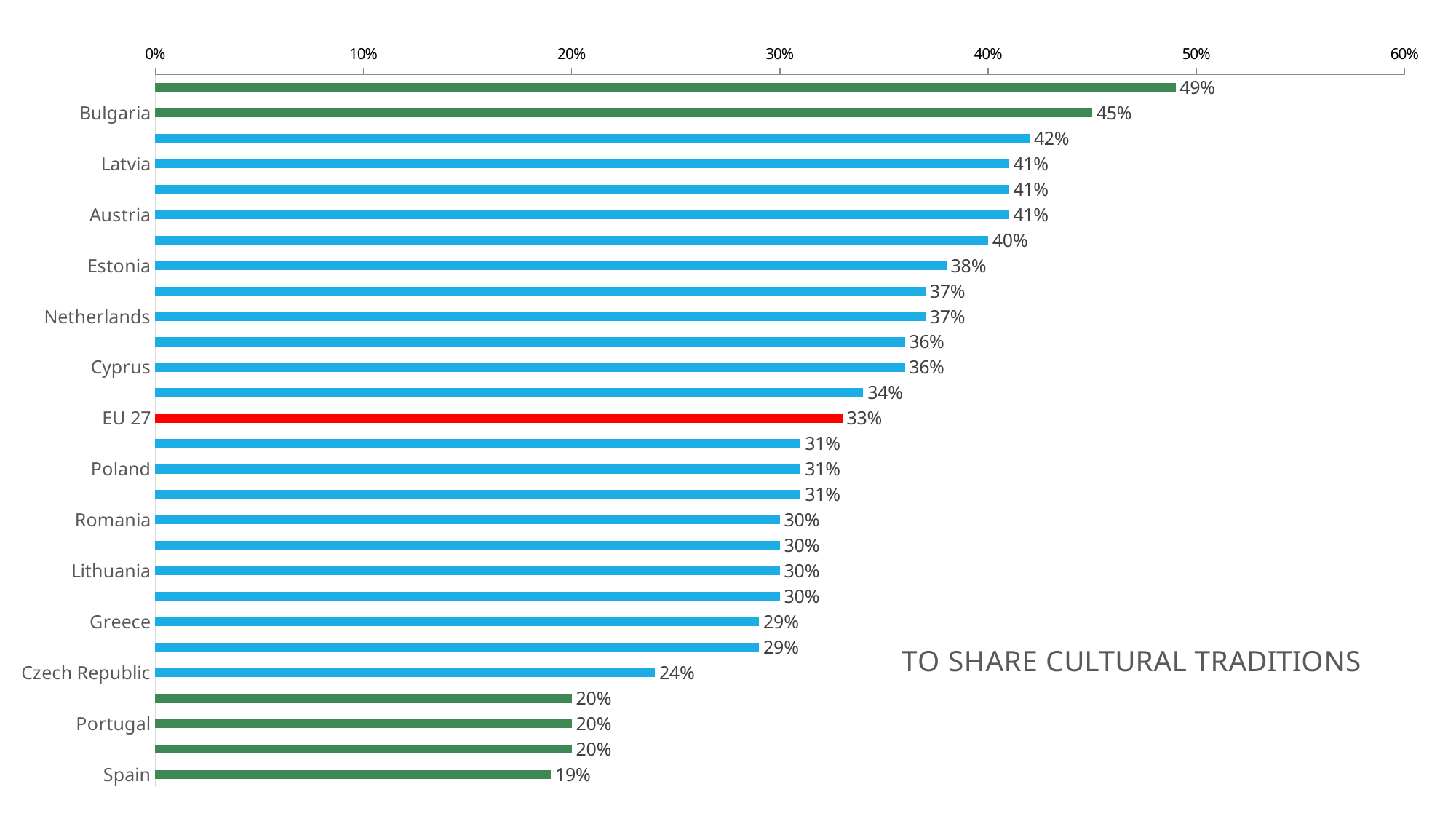
What is the title text shown on the chart? TO SHARE CULTURAL TRADITIONS Which is larger, the value for Latvia or the value for Poland? Latvia What is the difference between the values for Netherlands and EU 27? 4% What is the value for Estonia? 38% Is the value for Greece greater or less than 30%? less How many bars are plotted in the chart? 28 What is the value for Czech Republic? 24% What is the value for EU 27? 33% What is the difference between the values for Bulgaria and Spain? 26% What kind of chart is shown on the slide? Bar chart Which labelled category has the lowest value? Spain What is the value for Bulgaria? 45%